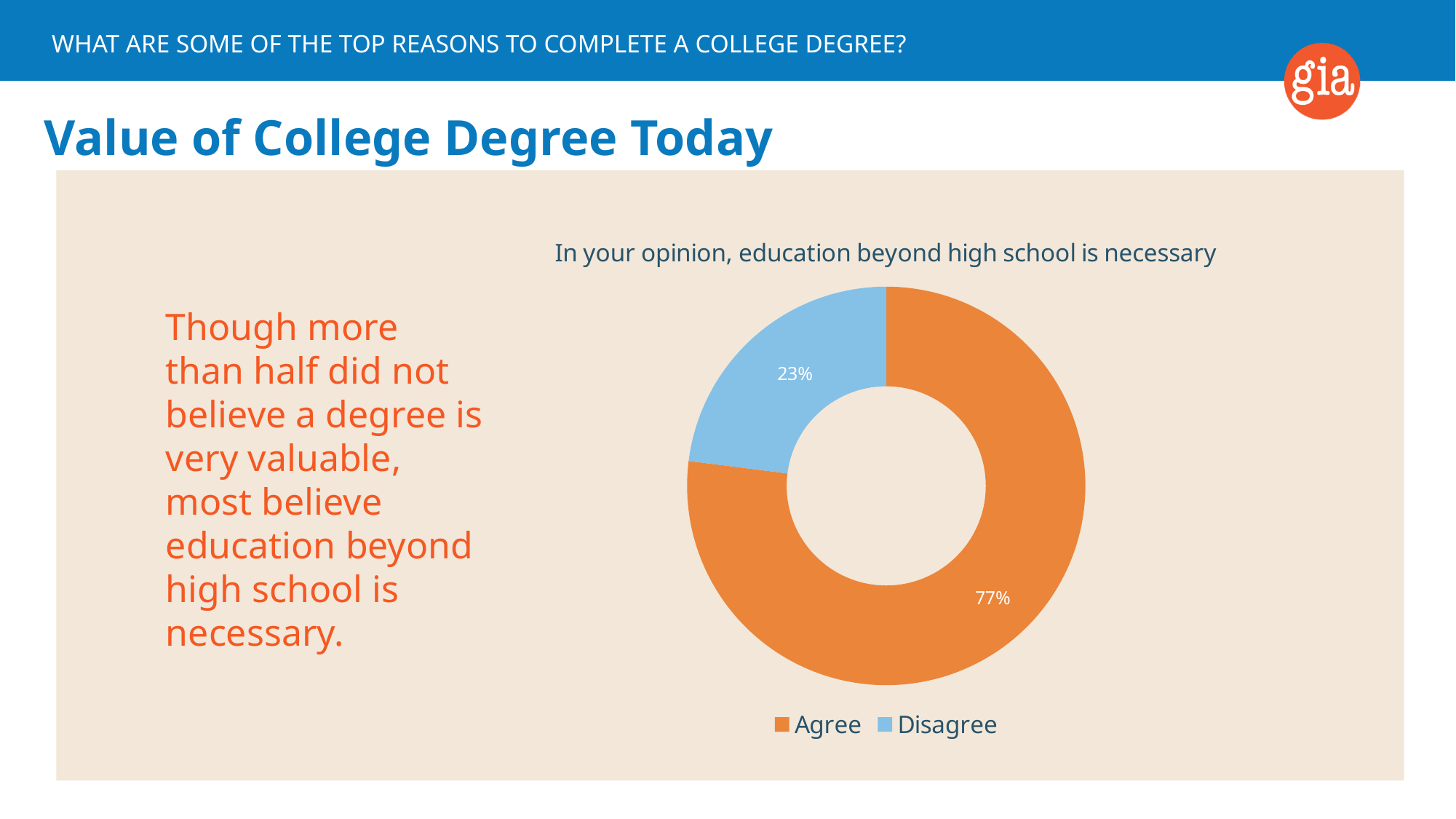
What kind of chart is shown on the slide? Pie chart (doughnut) Which response has the largest share of the chart? Agree What colour represents Agree in the chart? Orange How many categories does the chart show? 2 How many entries does the legend list? 2 Which response has the smallest share of the chart? Disagree What share of the pie does the Disagree slice represent? 23% What is the difference in percentage points between Agree and Disagree? 54 Which is larger, the share for Agree or the share for Disagree? Agree What percentage of respondents disagree that education beyond high school is necessary? 23% What percentage of respondents agree that education beyond high school is necessary? 77% What is the title of the chart? In your opinion, education beyond high school is necessary